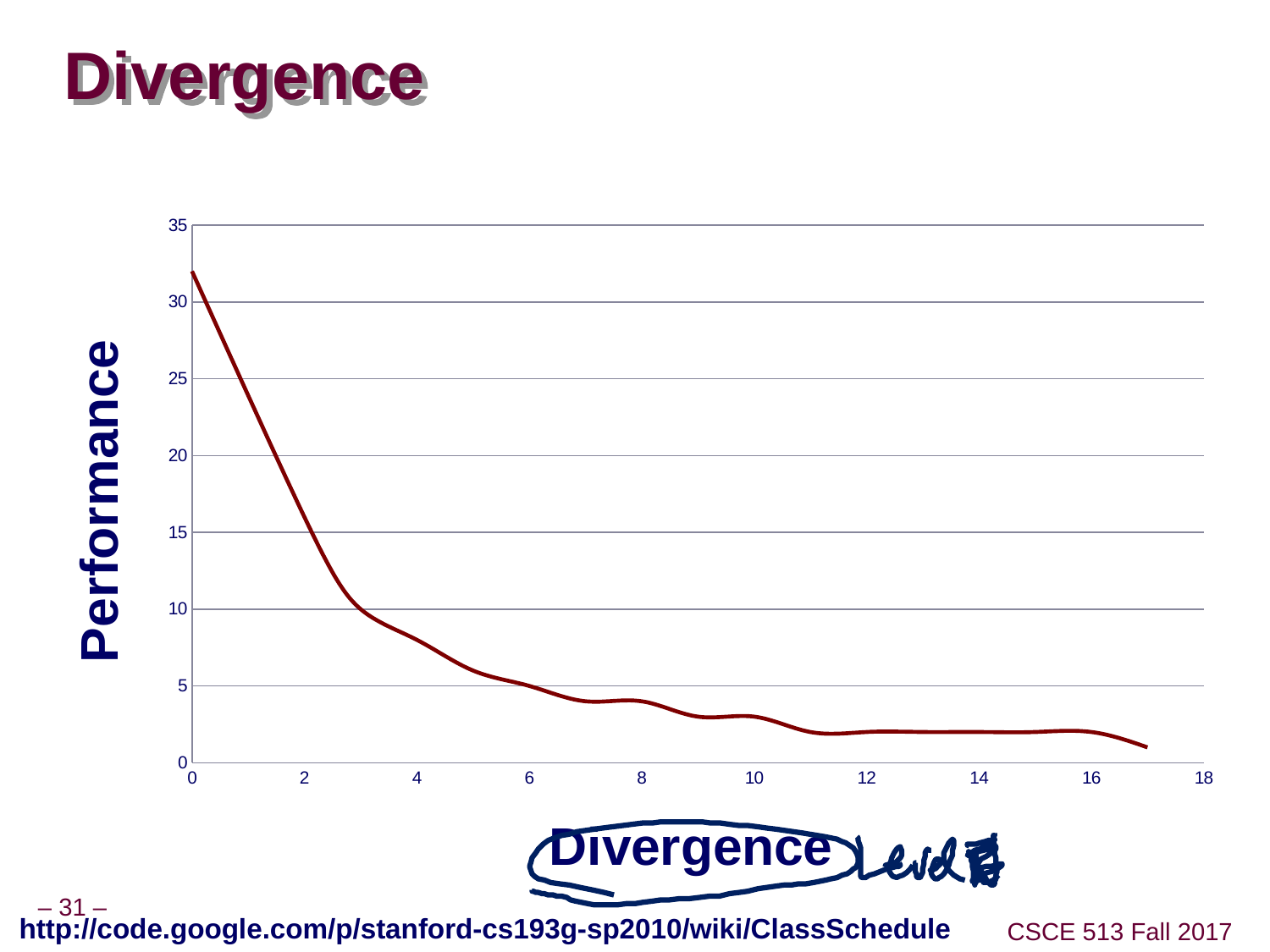
What kind of chart is shown on the slide? line chart What is the label of the y axis? Performance At which Divergence value is Performance highest? 0 Which has the higher Performance value: Divergence 2 or Divergence 10? Divergence 2 Is the Performance value at Divergence 8 greater or less than 5? less Is the Performance value at Divergence 12 greater or less than 5? less Is the Performance value at Divergence 0 greater or less than 30? greater How many lines are plotted on the chart? 1 What is the label of the x axis? Divergence Does Performance rise or fall as Divergence increases along the x axis? fall